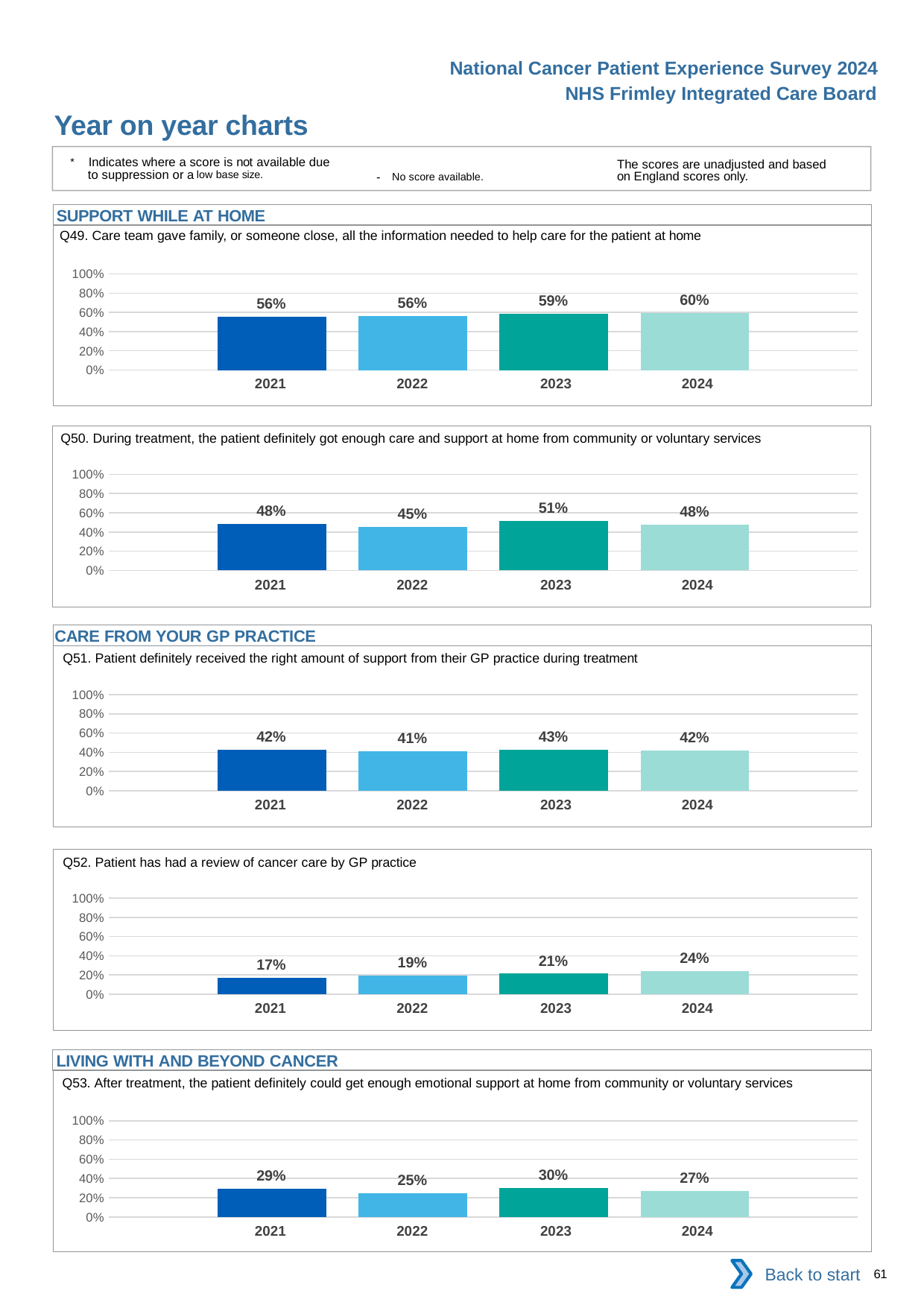
In the Q49 chart, what is the value for 2024? 60% In the Q52 chart, do the values rise or fall from 2021 to 2024? rise In the Q50 chart, what is the difference between the 2023 and 2022 values? 6% In the Q50 chart, which year has the highest value? 2023 What kind of chart is the Q51 chart? bar chart In the Q51 chart, what is the value for 2022? 41% In the Q53 chart, which is larger, the value for 2021 or the value for 2022? 2021 How many years are shown in the Q49 chart? 4 Which section heading appears above the Q53 chart? LIVING WITH AND BEYOND CANCER In the Q52 chart, which year has the lowest value? 2021 In the Q49 chart, is the value for 2023 greater or less than 40%? greater In the Q53 chart, what is the difference between the 2023 and 2024 values? 3%